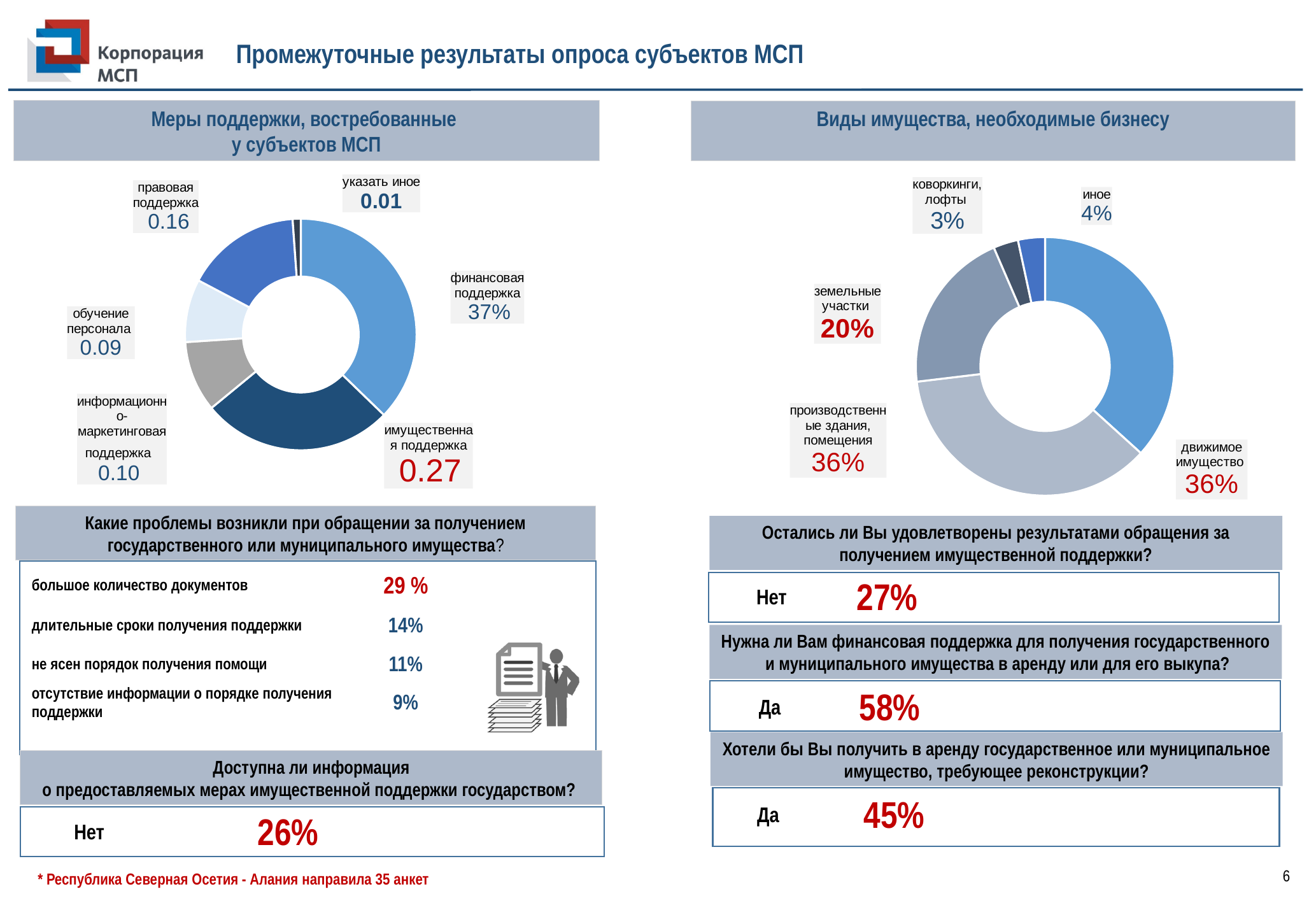
What kind of chart is 'Виды имущества, необходимые бизнесу'? doughnut (pie) chart How many categories are shown in the chart 'Виды имущества, необходимые бизнесу'? 5 In the chart 'Меры поддержки, востребованные у субъектов МСП', which category has the smallest share? указать иное In the chart 'Виды имущества, необходимые бизнесу', what is the value for коворкинги, лофты? 3% In the chart 'Меры поддержки, востребованные у субъектов МСП', what is the value for обучение персонала? 0.09 In the chart 'Меры поддержки, востребованные у субъектов МСП', which category has the largest share? финансовая поддержка In the chart 'Виды имущества, необходимые бизнесу', what is the value for земельные участки? 20% How many categories are shown in the chart 'Меры поддержки, востребованные у субъектов МСП'? 6 In the chart 'Меры поддержки, востребованные у субъектов МСП', what is the value for финансовая поддержка? 37% In the chart 'Меры поддержки, востребованные у субъектов МСП', what is the value for имущественная поддержка? 0.27 In the chart 'Виды имущества, необходимые бизнесу', what is the difference between производственные здания, помещения and земельные участки? 16% In the chart 'Виды имущества, необходимые бизнесу', which category has the smallest share? коворкинги, лофты